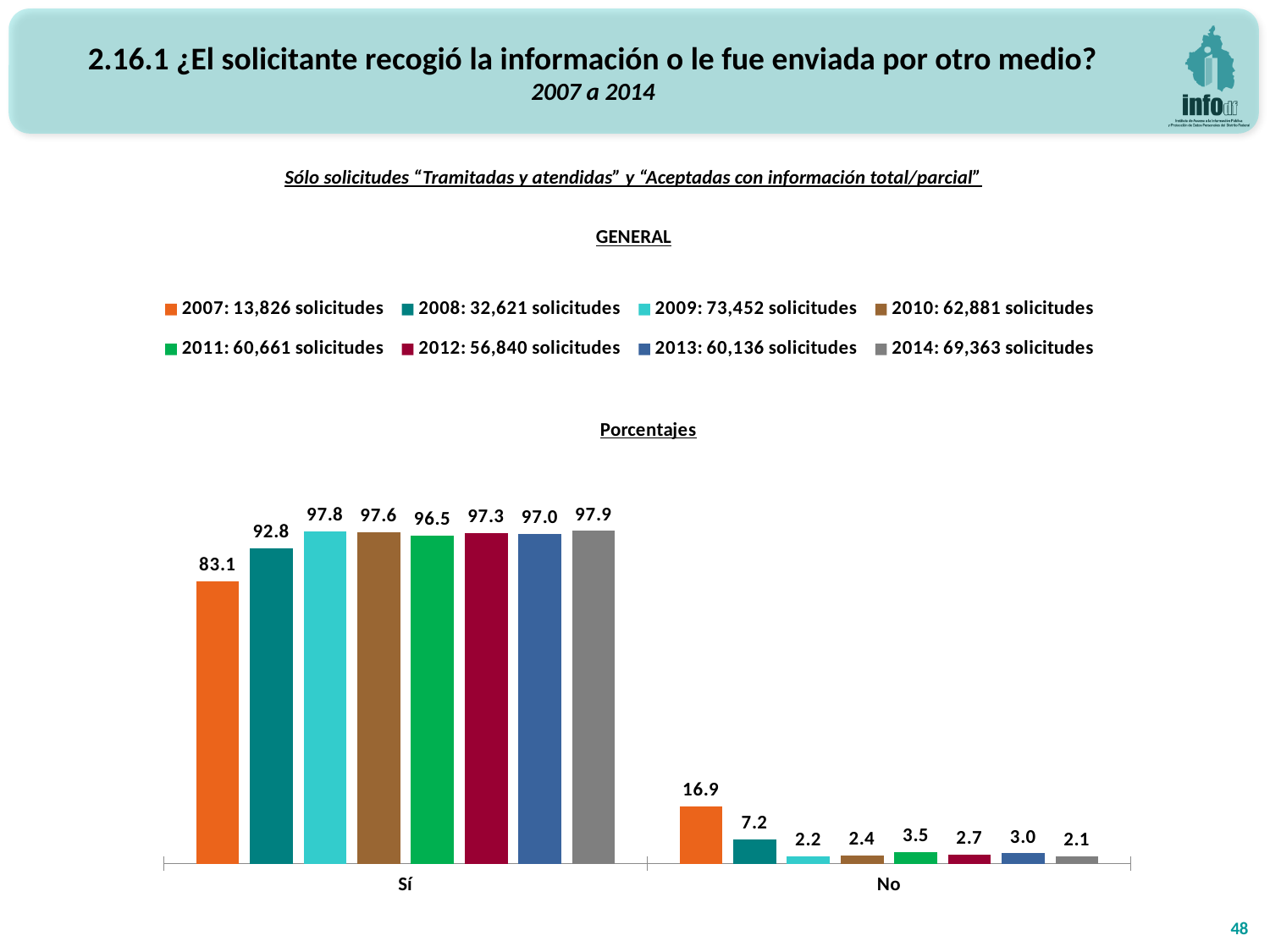
Which year has the highest value in the "Sí" category? 2014 According to the legend, how many solicitudes were there in 2009? 73,452 What is the difference between the 2007 and 2008 values in the "No" category? 9.7 What is the value for 2011 in the "Sí" category? 96.5 How many series does the legend list? 8 Which is larger in the "Sí" category: the value for 2008 or the value for 2012? 2012 What is the value for 2007 in the "Sí" category? 83.1 Which year has the lowest value in the "No" category? 2014 Which year has the highest value in the "No" category? 2007 What kind of chart is shown on the slide? Bar chart What is the value for 2014 in the "No" category? 2.1 How many categories are shown on the x axis? 2